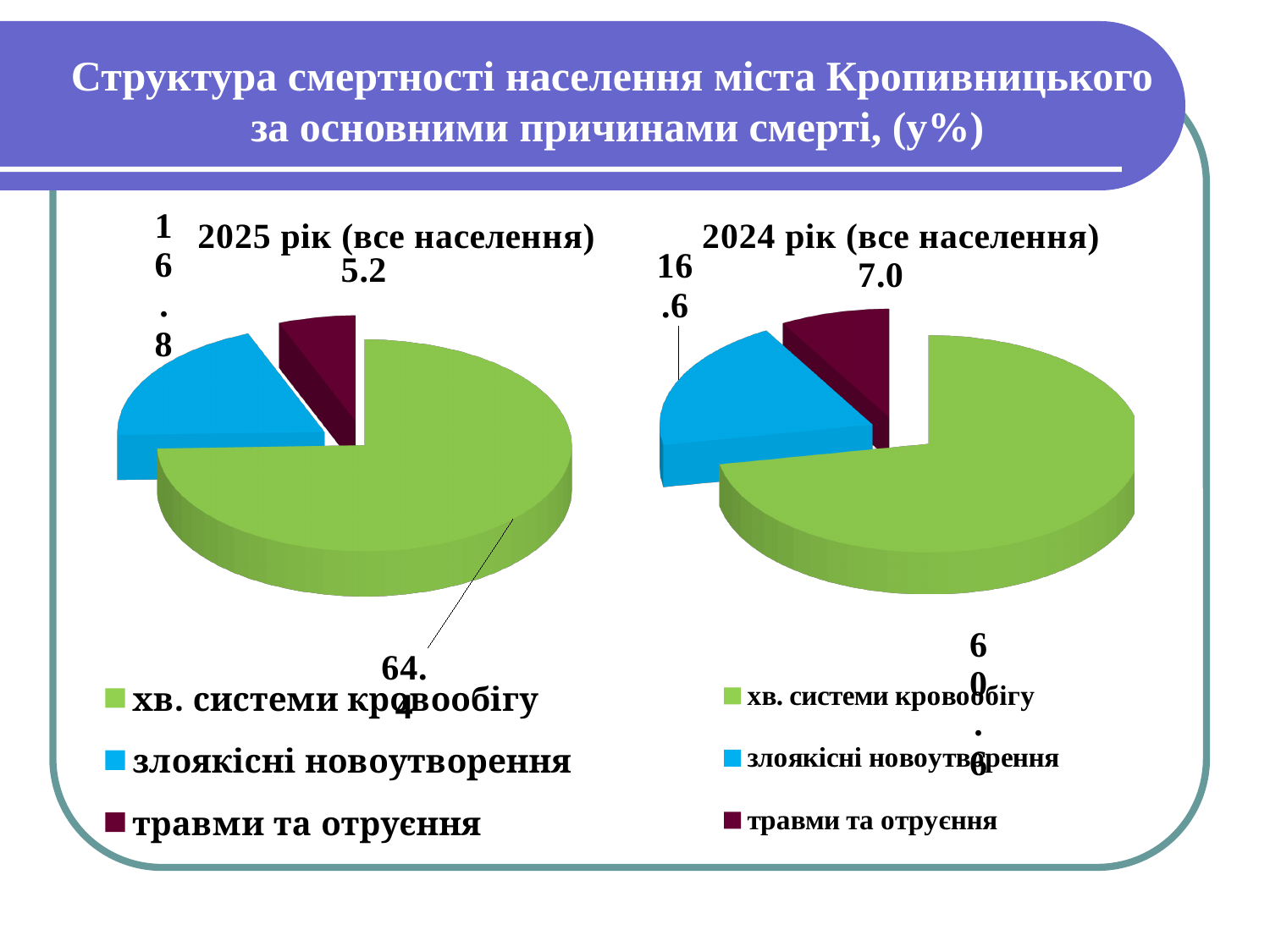
In the '2024 рік (все населення)' chart, what is the value for хв. системи кровообігу? 60.6 In the '2025 рік (все населення)' chart, what is the value for травми та отруєння? 5.2 In the '2024 рік (все населення)' chart, what is the value for злоякісні новоутворення? 16.6 Which is larger: травми та отруєння in the 2025 chart or травми та отруєння in the 2024 chart? 2024 chart In the '2024 рік (все населення)' chart, what is the value for травми та отруєння? 7.0 In the '2024 рік (все населення)' chart, which category has the smallest slice? травми та отруєння In the '2025 рік (все населення)' chart, what is the value for злоякісні новоутворення? 16.8 What is the difference between the травми та отруєння values in the 2024 and 2025 charts? 1.8 In the '2025 рік (все населення)' chart, what colour is the slice for злоякісні новоутворення? blue What kind of chart is the '2025 рік (все населення)' chart? pie chart In the '2025 рік (все населення)' chart, which category has the largest slice? хв. системи кровообігу How many categories does the '2024 рік (все населення)' chart show? 3